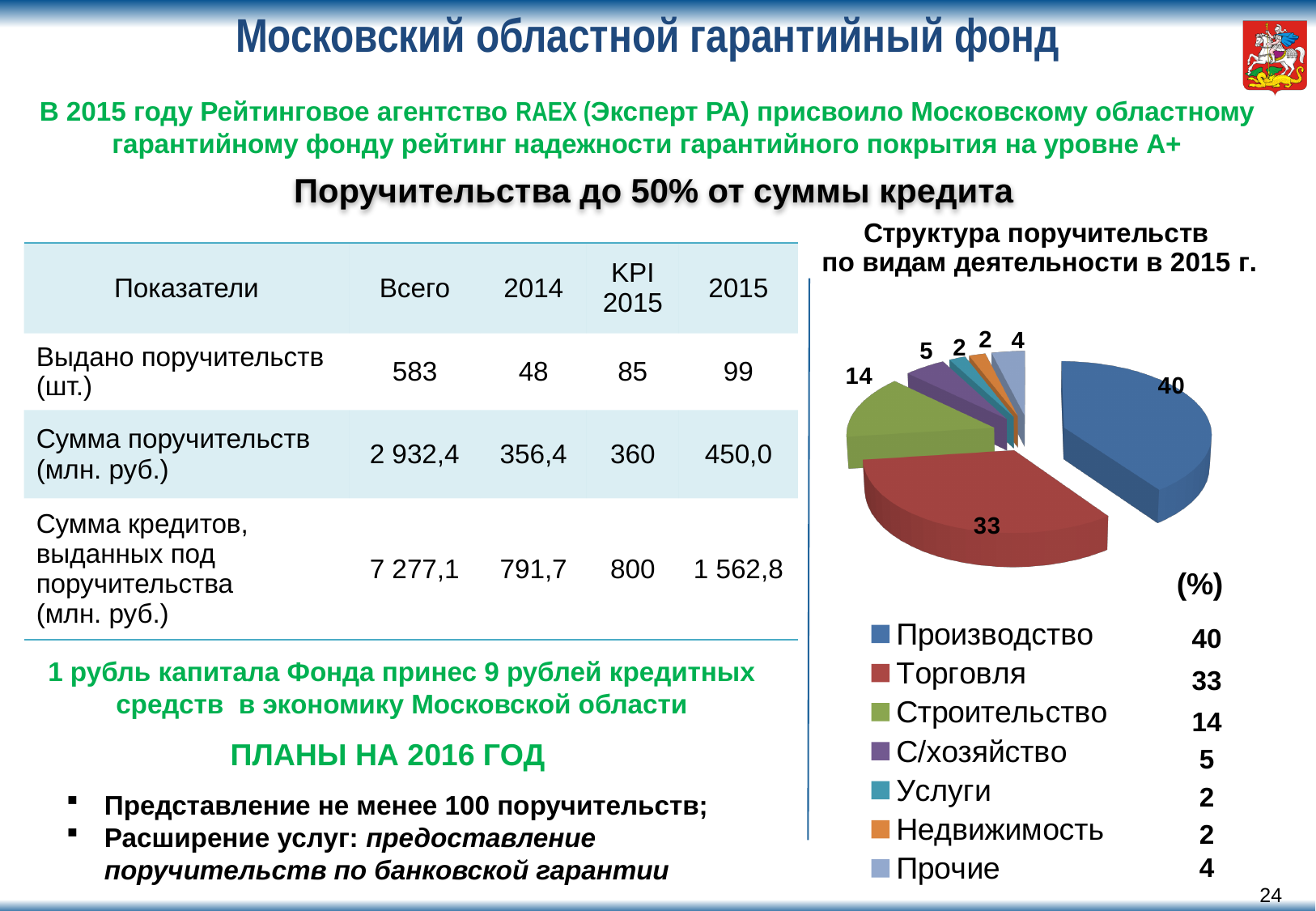
Which category has the largest slice in the pie chart? Производство What is the value for Производство in the pie chart? 40 What is the value for Прочие in the pie chart? 4 Which is larger, Строительство or С/хозяйство? Строительство How many categories does the pie chart show? 7 What is the title of the pie chart? Структура поручительств по видам деятельности в 2015 г. What colour is the Торговля slice in the pie chart? red What kind of chart is shown on the slide? pie chart What is the value for Строительство in the pie chart? 14 What is the value for Торговля in the pie chart? 33 What is the difference between the values for Производство and Торговля? 7 What is the value for С/хозяйство in the pie chart? 5